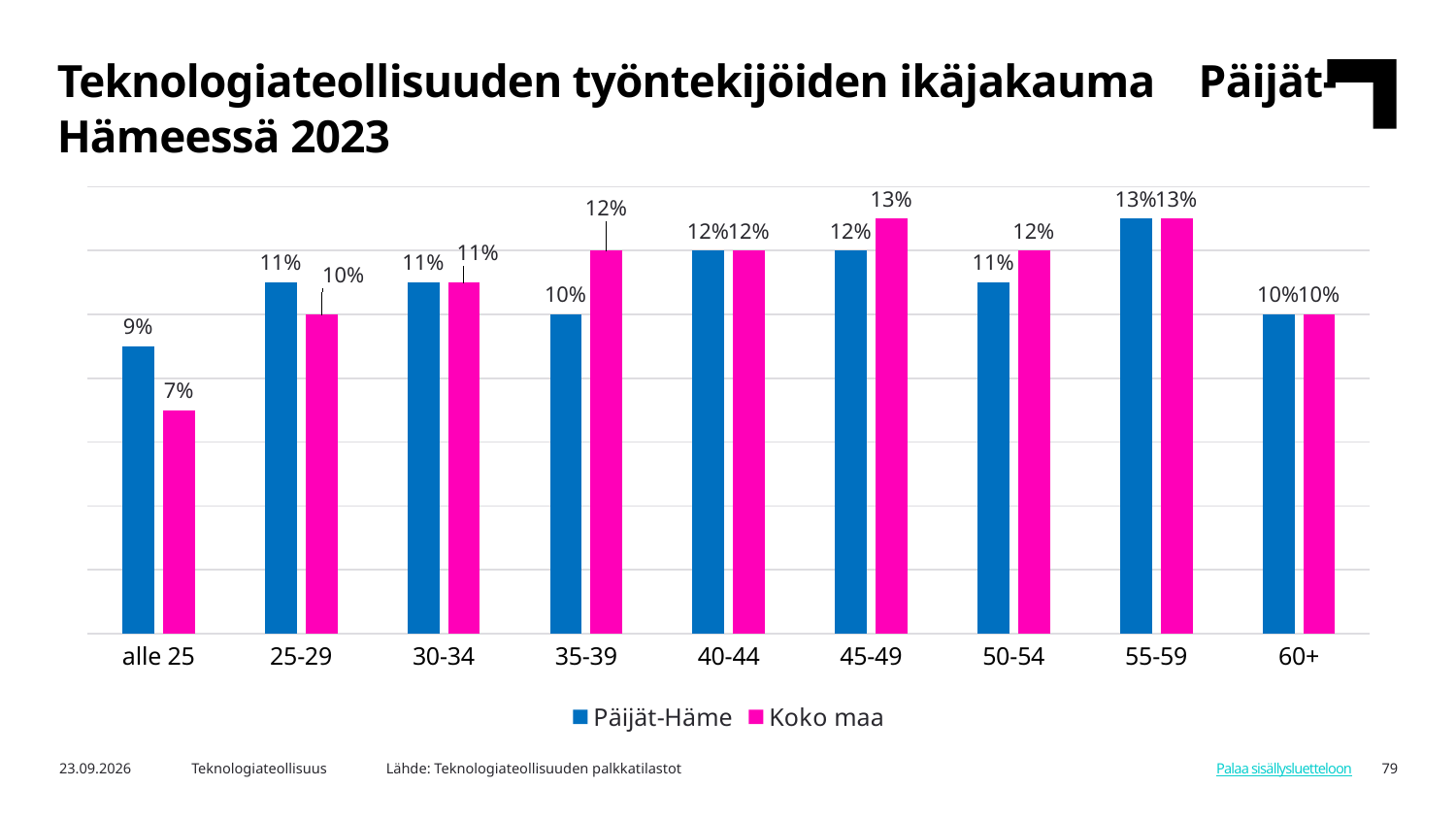
What is the value for Koko maa in the alle 25 age group? 7% What is the difference between the Päijät-Häme and Koko maa values in the alle 25 age group? 2 percentage points How many age groups are shown on the x axis? 9 What is the value for Päijät-Häme in the 55-59 age group? 13% Which age group has the highest value for Päijät-Häme? 55-59 How many series does the legend list? 2 In the 35-39 age group, which series has the larger value, Päijät-Häme or Koko maa? Koko maa Which series is shown in pink in the legend? Koko maa What is the value for Koko maa in the 35-39 age group? 12% What is the value for Päijät-Häme in the alle 25 age group? 9% Which age group has the lowest value for Koko maa? alle 25 What kind of chart is shown on the slide? Bar chart